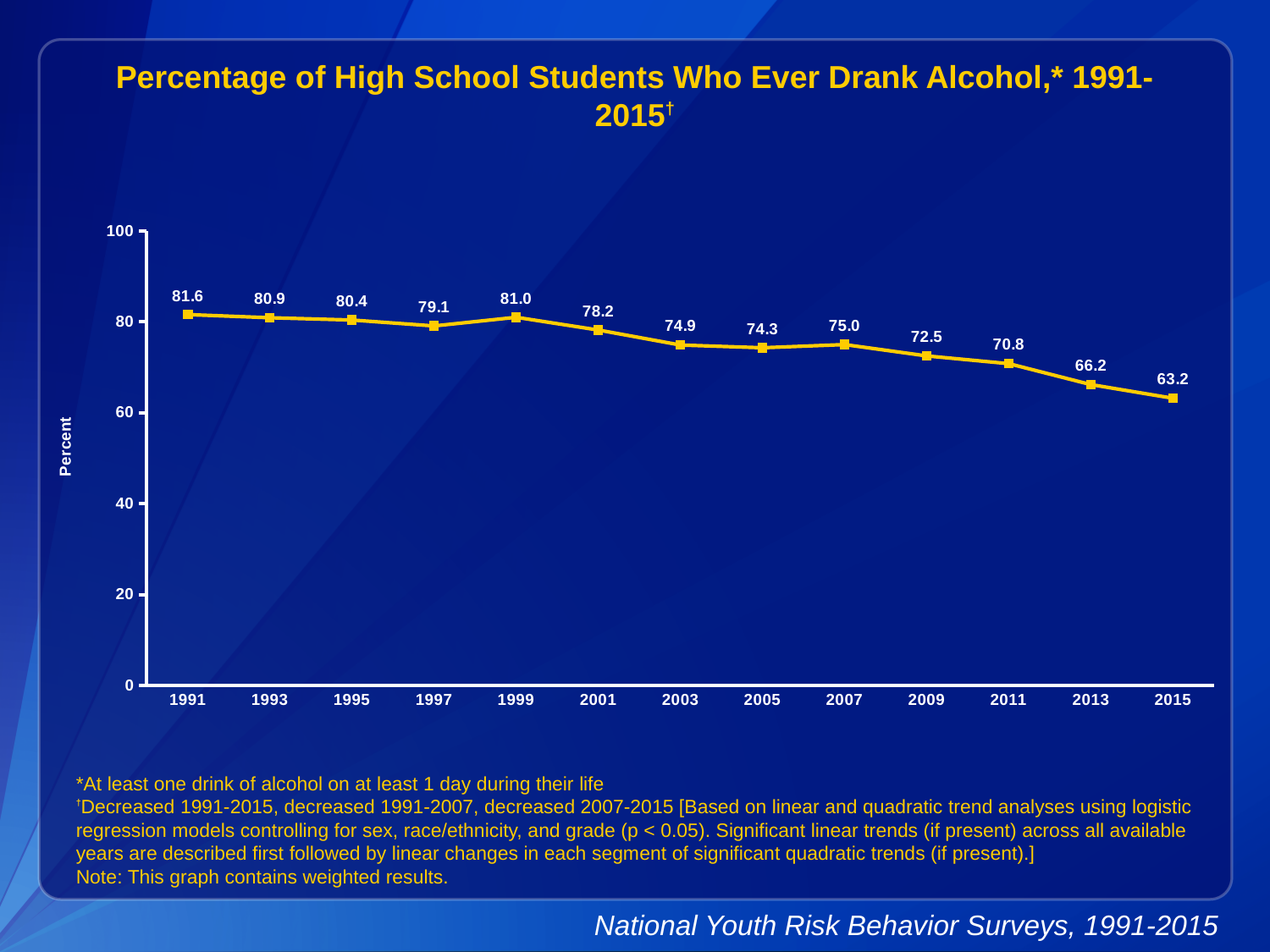
Which year has the larger value, 1999 or 2001? 1999 Which year has the lowest value on the chart? 2015 Is the value for 2011 greater or less than 80? less What is the value plotted for 2015? 63.2 What kind of chart is shown on the slide? line chart Which year has the highest value on the chart? 1991 Do the values generally rise or fall from 1991 to 2015? fall What is the difference between the values for 2013 and 2015? 3.0 What percentage of high school students had ever drunk alcohol in 1991? 81.6 What is the value plotted for 2007? 75.0 By how many percentage points did the value fall from 1991 to 2015? 18.4 How many years are plotted on the x axis? 13